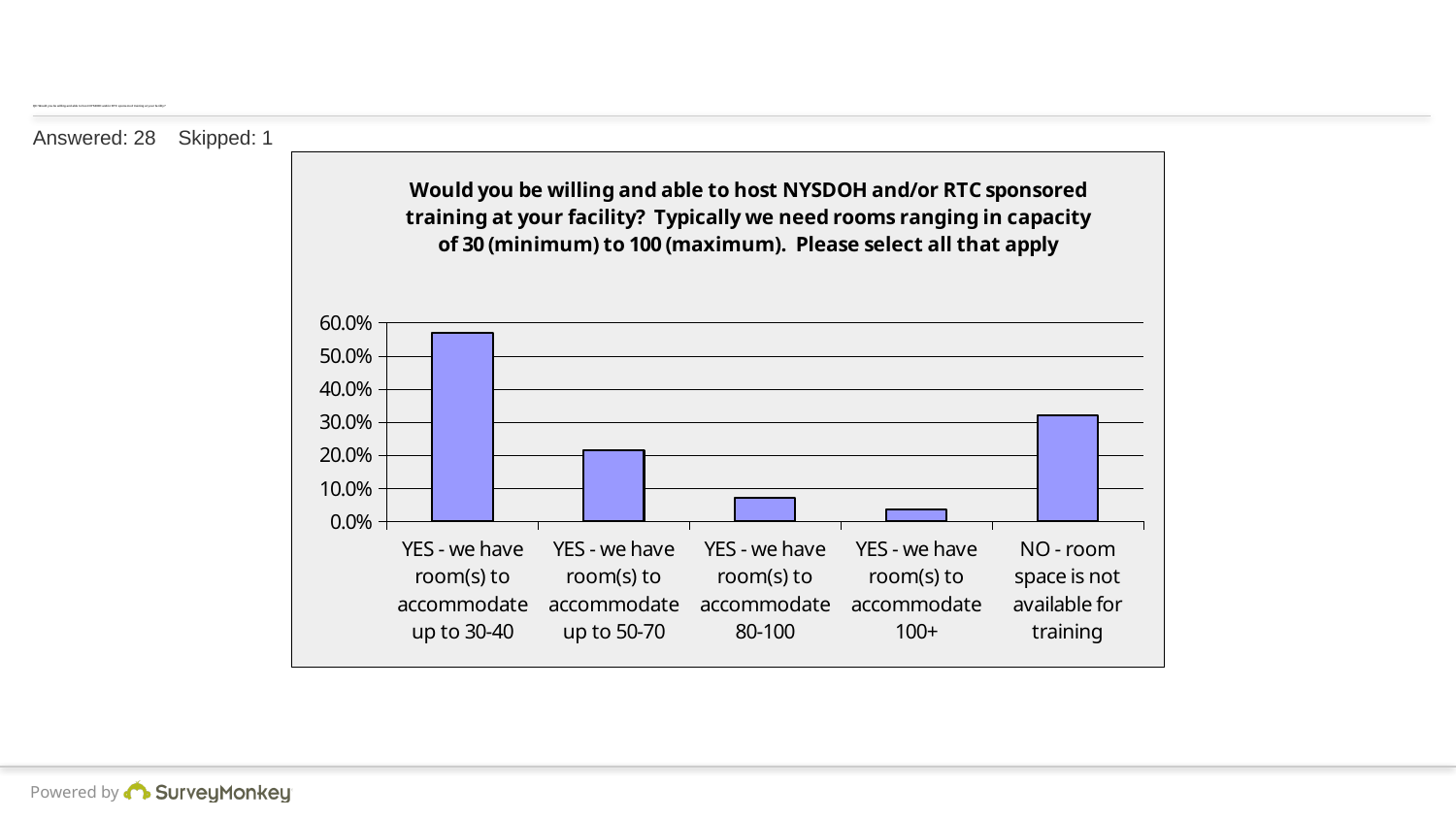
How many respondents answered the survey question shown on the slide? 28 Which is larger: the value for 'NO - room space is not available for training' or the value for 'YES - we have room(s) to accommodate up to 50-70'? NO - room space is not available for training How many categories are shown on the x axis of the chart? 5 Is the value for 'YES - we have room(s) to accommodate up to 50-70' greater or less than 30.0%? less Which category has the highest value in the chart? YES - we have room(s) to accommodate up to 30-40 Is the value for 'YES - we have room(s) to accommodate 80-100' greater or less than 10.0%? less Is the value for 'YES - we have room(s) to accommodate up to 30-40' greater or less than 50.0%? greater Which category has the lowest value in the chart? YES - we have room(s) to accommodate 100+ What type of chart is shown on the slide? bar chart Which is larger: the value for 'YES - we have room(s) to accommodate 80-100' or the value for 'YES - we have room(s) to accommodate 100+'? YES - we have room(s) to accommodate 80-100 What is the maximum value shown on the y axis of the chart? 60.0%